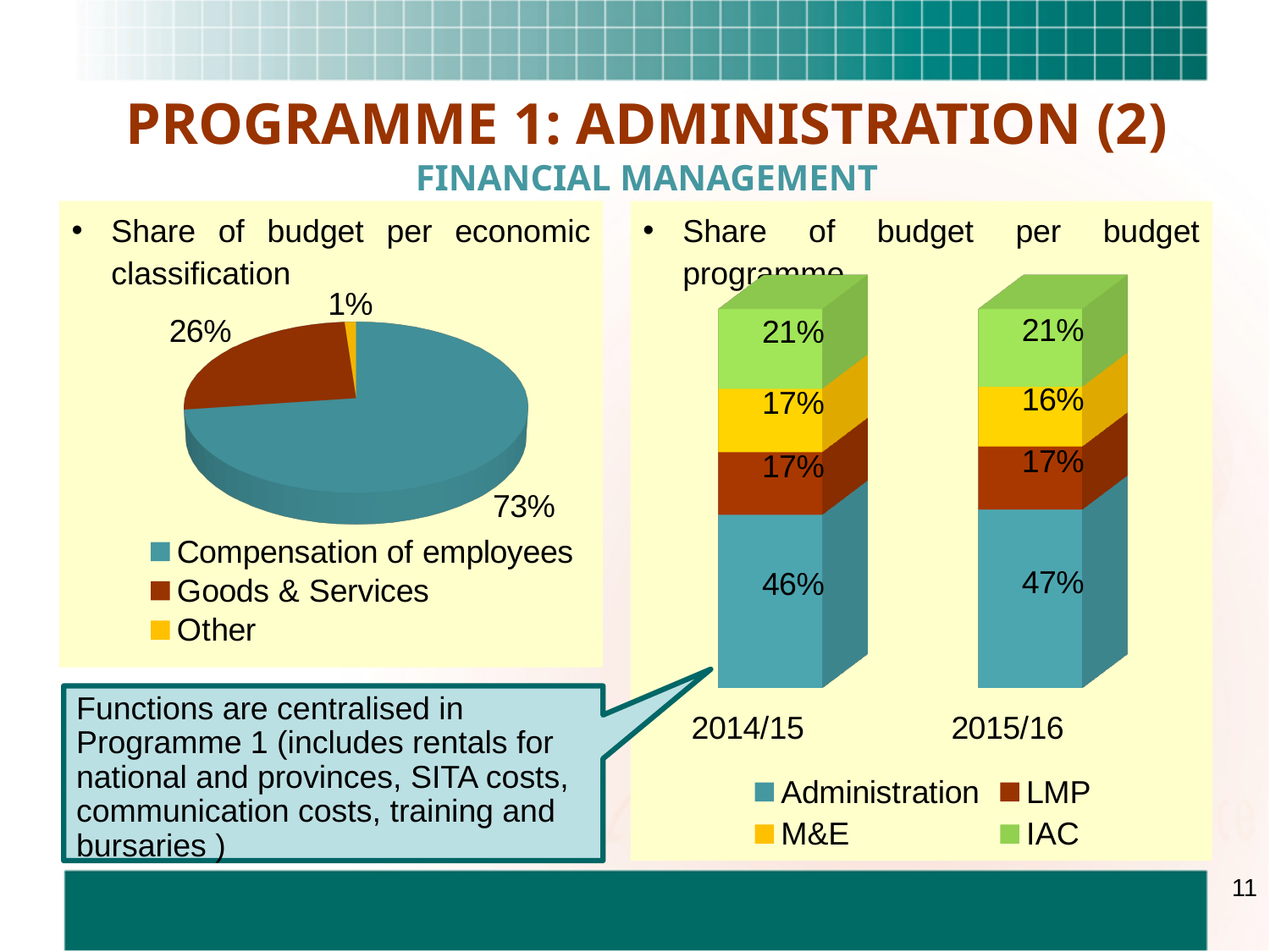
How many categories does the legend of the pie chart on the left list? 3 In the pie chart on the left, what share of the budget goes to Compensation of employees? 73% How many series does the legend of the stacked bar chart on the right list? 4 What kind of chart is the chart on the left? Pie chart In the pie chart on the left, what share of the budget goes to Goods & Services? 26% In the pie chart on the left, which category has the smallest share? Other In the stacked bar chart on the right, is the Administration share larger in 2014/15 or 2015/16? 2015/16 In the stacked bar chart on the right, what is the share for M&E in 2015/16? 16% In the stacked bar chart on the right, what is the share for Administration in 2014/15? 46% In the stacked bar chart on the right, what is the share for IAC in 2015/16? 21% In the stacked bar chart on the right, which series is shown in green? IAC In the pie chart on the left, what is the difference between the shares for Compensation of employees and Goods & Services? 47 percentage points